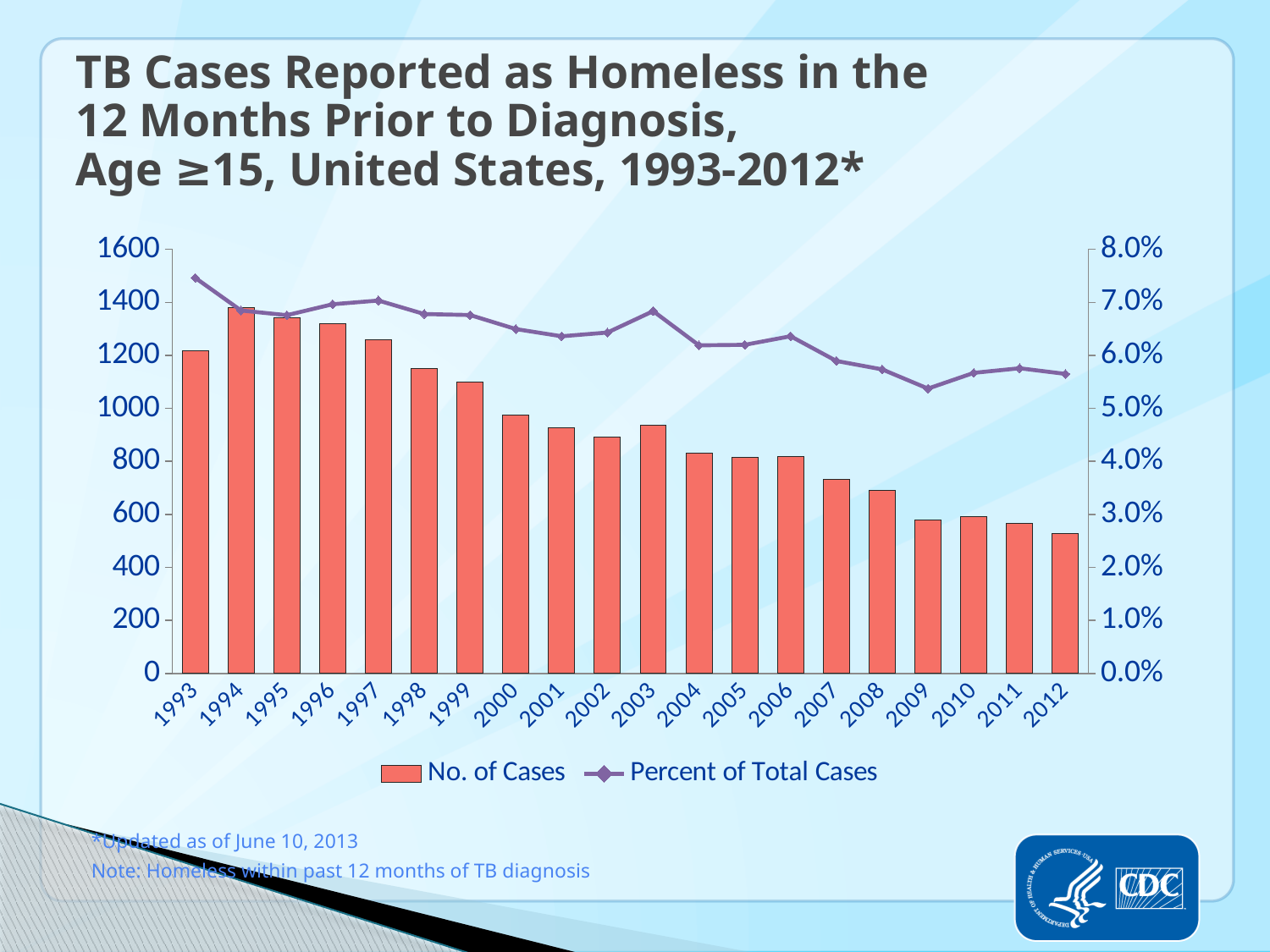
Which year has the lowest percent of total cases on the line? 2009 Which year has the highest percent of total cases on the line? 1993 How many series does the legend list? 2 Overall, does the number of cases rise or fall from 1993 to 2012? Fall Which year has the lowest number of cases (shortest bar)? 2012 Which year has the highest number of cases (tallest bar)? 1994 Is the percent of total cases for 2003 greater or less than 6.0%? greater What kind of chart is shown on the slide? A combined bar and line chart How many years are plotted along the x axis? 20 Which year has more cases, 1997 or 2000? 1997 Is the number of cases for 1998 greater or less than 1000? greater Is the number of cases for 2012 greater or less than 600? less